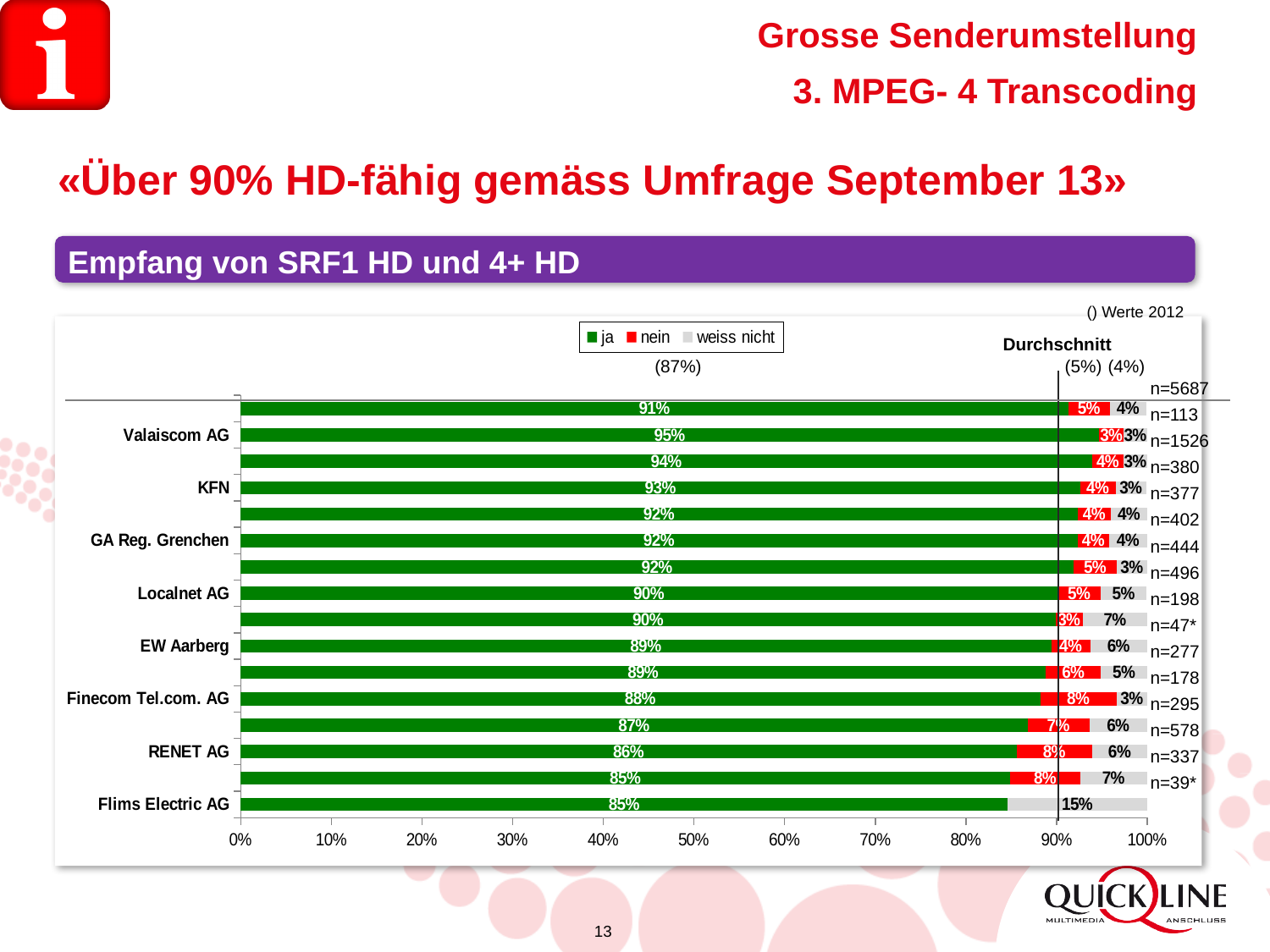
What kind of chart is shown on the slide? Stacked horizontal bar chart Which has a higher "ja" value, KFN or Localnet AG? KFN What are the three legend entries of the chart? ja, nein, weiss nicht How many series does the legend list? 3 What is the "weiss nicht" value for Flims Electric AG? 15% Do the "ja" values rise or fall going from the top bar to the bottom bar? Fall What is the "ja" value for Valaiscom AG? 95% What is the "nein" value for Finecom Tel.com. AG? 8% What is the difference in percentage points between the "ja" values of Valaiscom AG and RENET AG? 9 percentage points Which labelled provider has the highest "weiss nicht" share? Flims Electric AG Which labelled provider has the highest "ja" share? Valaiscom AG What is the "weiss nicht" value for EW Aarberg? 6%